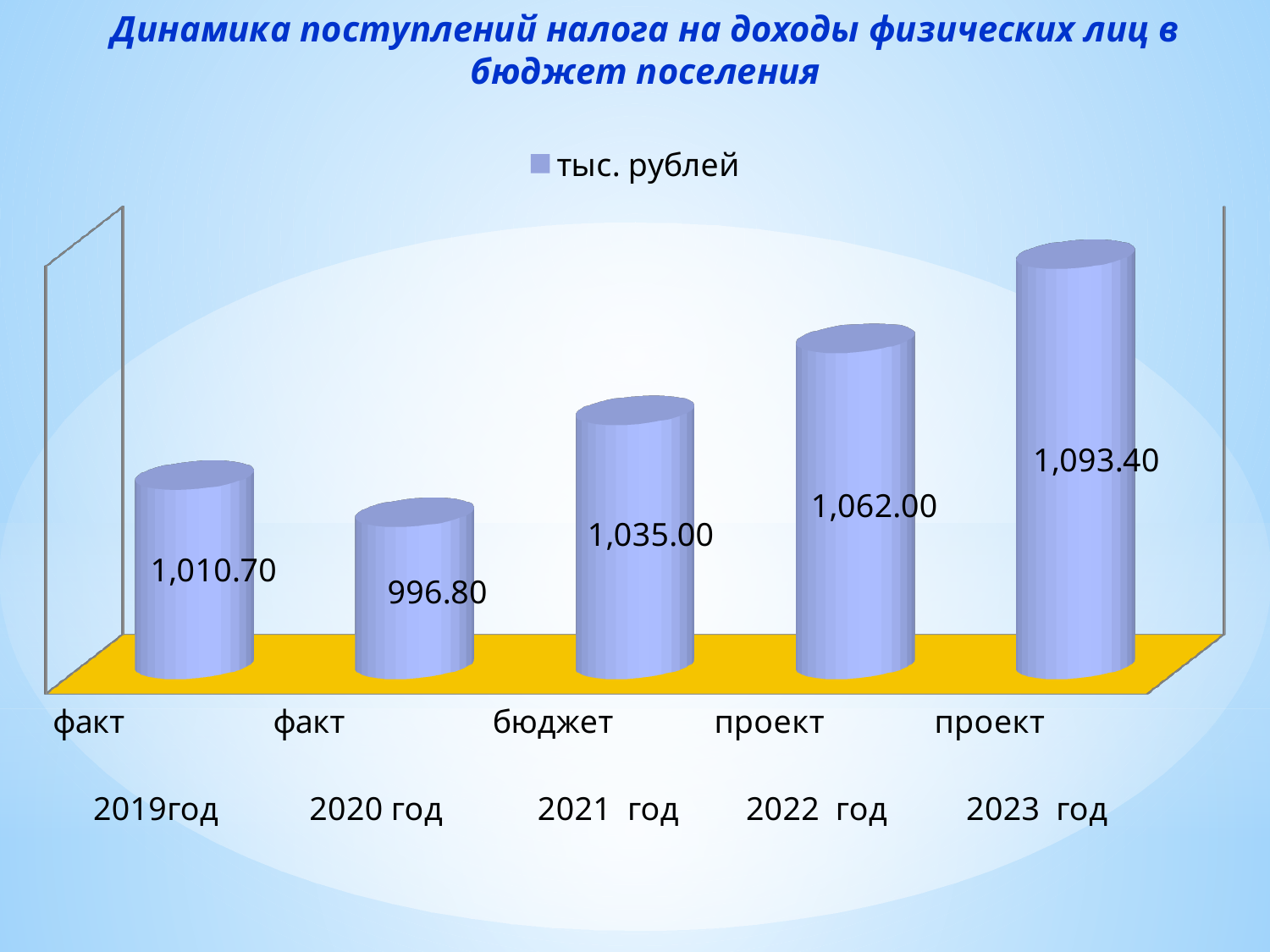
Which is larger, the value for 2019 год or the value for 2021 год? 2021 год What is the difference between the values for 2023 год and 2022 год? 31.40 Which year has the highest value? 2023 год What is the difference between the values for 2019 год and 2020 год? 13.90 How many series does the legend list? 1 What is the value for 2023 год (проект)? 1,093.40 What kind of chart is shown on the slide? bar chart What is the value for 2020 год (факт)? 996.80 Do the values rise or fall from 2020 год to 2023 год? rise How many bars are shown in the chart? 5 Which year has the lowest value? 2020 год What is the value for 2021 год (бюджет)? 1,035.00